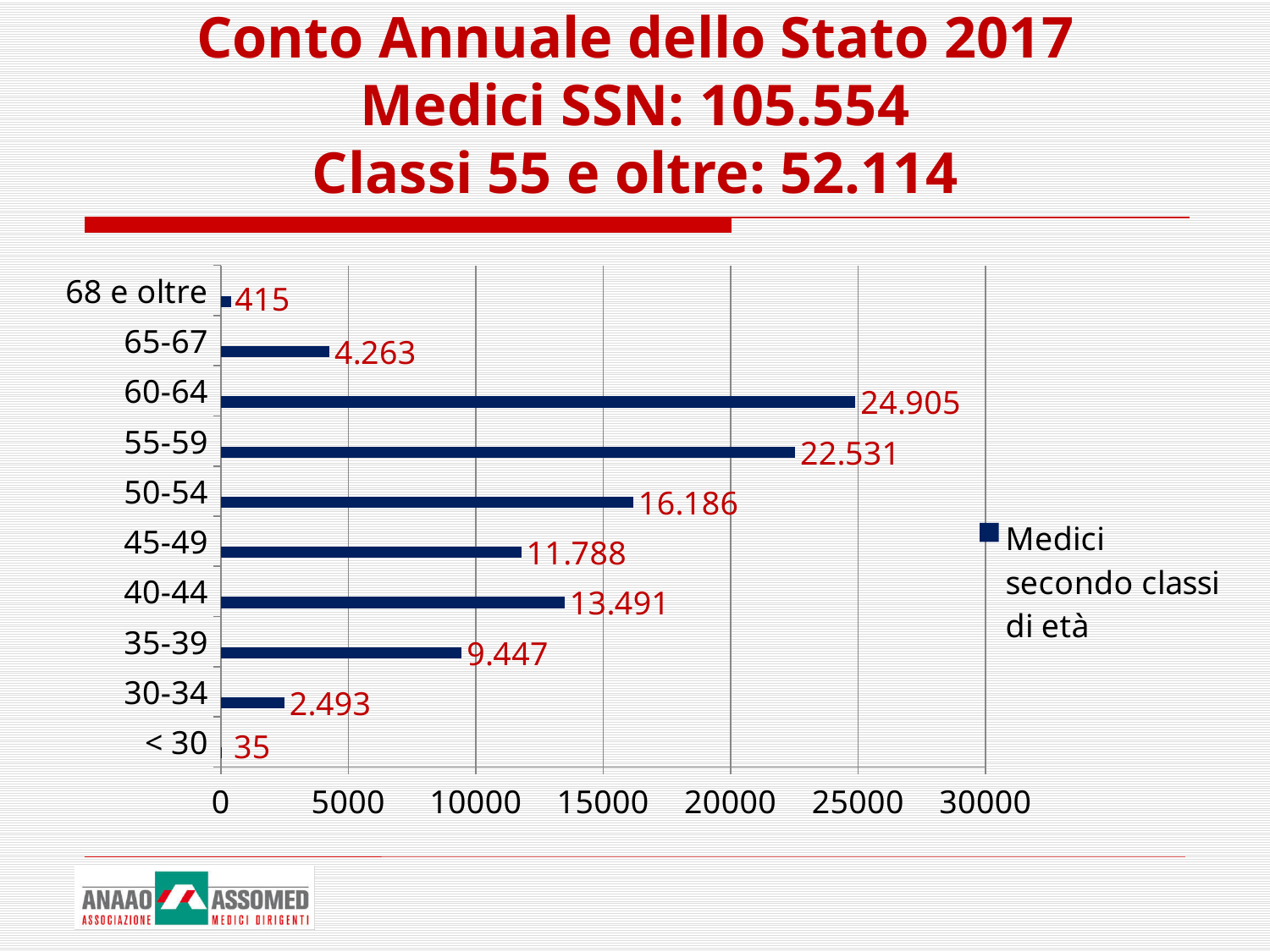
How many age classes are shown in the chart? 10 What series name does the legend show? Medici secondo classi di età Is the value for the 55-59 age class greater or less than 20000? greater What is the value for the 35-39 age class? 9.447 What is the difference between the values for the 60-64 and 55-59 age classes? 2.374 What is the value for the < 30 age class? 35 What is the difference between the values for the 40-44 and 45-49 age classes? 1.703 Which age class has the lowest value? < 30 Which is larger, the value for 50-54 or the value for 40-44? 50-54 What kind of chart is shown on the slide? Bar chart Which age class has the highest value? 60-64 What is the value for the 60-64 age class? 24.905